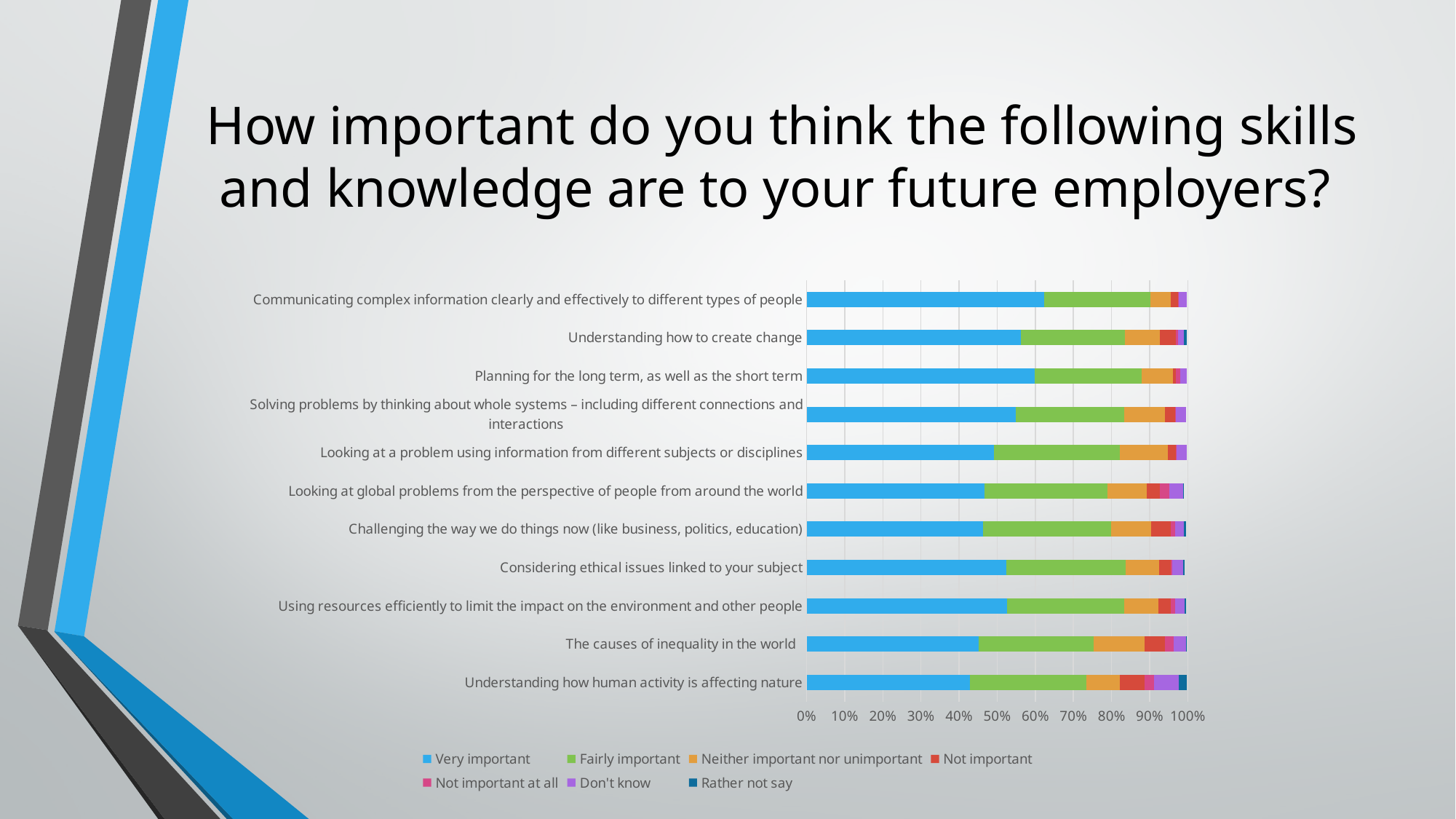
Is the 'Very important' value for 'Understanding how human activity is affecting nature' greater or less than 50%? less How many skills or knowledge areas (categories) are listed on the chart? 11 What is the title of the slide's chart? How important do you think the following skills and knowledge are to your future employers? Is the 'Very important' value for 'The causes of inequality in the world' greater or less than 50%? less Which has a larger 'Very important' share: 'Communicating complex information clearly and effectively to different types of people' or 'Understanding how human activity is affecting nature'? Communicating complex information clearly and effectively to different types of people Is the 'Very important' value for 'Understanding how to create change' greater or less than 50%? greater How many series does the chart legend list? 7 Which has a larger 'Very important' share: 'Planning for the long term, as well as the short term' or 'The causes of inequality in the world'? Planning for the long term, as well as the short term What kind of chart is shown on the slide? Stacked bar chart Which legend entry is shown in blue? Very important